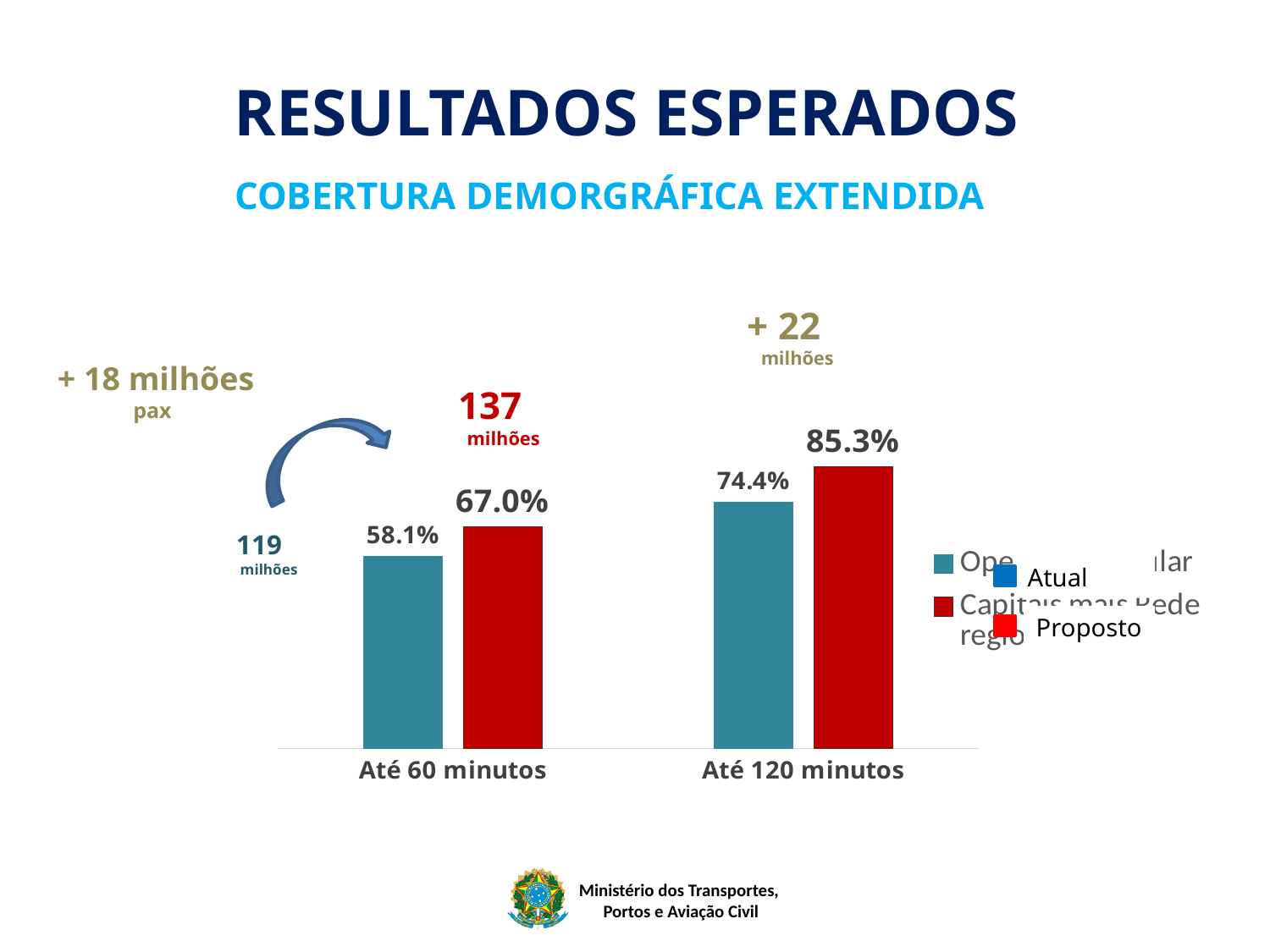
How many categories are shown on the x axis of the chart? 2 Which bar has the highest value in the chart? Proposto, Até 120 minutos What is the difference between the Proposto and Atual values for Até 60 minutos? 8.9% What is the Atual value for Até 60 minutos? 58.1% What is the difference between the Proposto and Atual values for Até 120 minutos? 10.9% What type of chart is shown on the slide? Bar chart What is the Proposto value for Até 60 minutos? 67.0% Which colour represents the Proposto series in the chart? Red What is the Atual value for Até 120 minutos? 74.4% Which is larger for Até 120 minutos, Atual or Proposto? Proposto Which bar has the lowest value in the chart? Atual, Até 60 minutos What is the Proposto value for Até 120 minutos? 85.3%